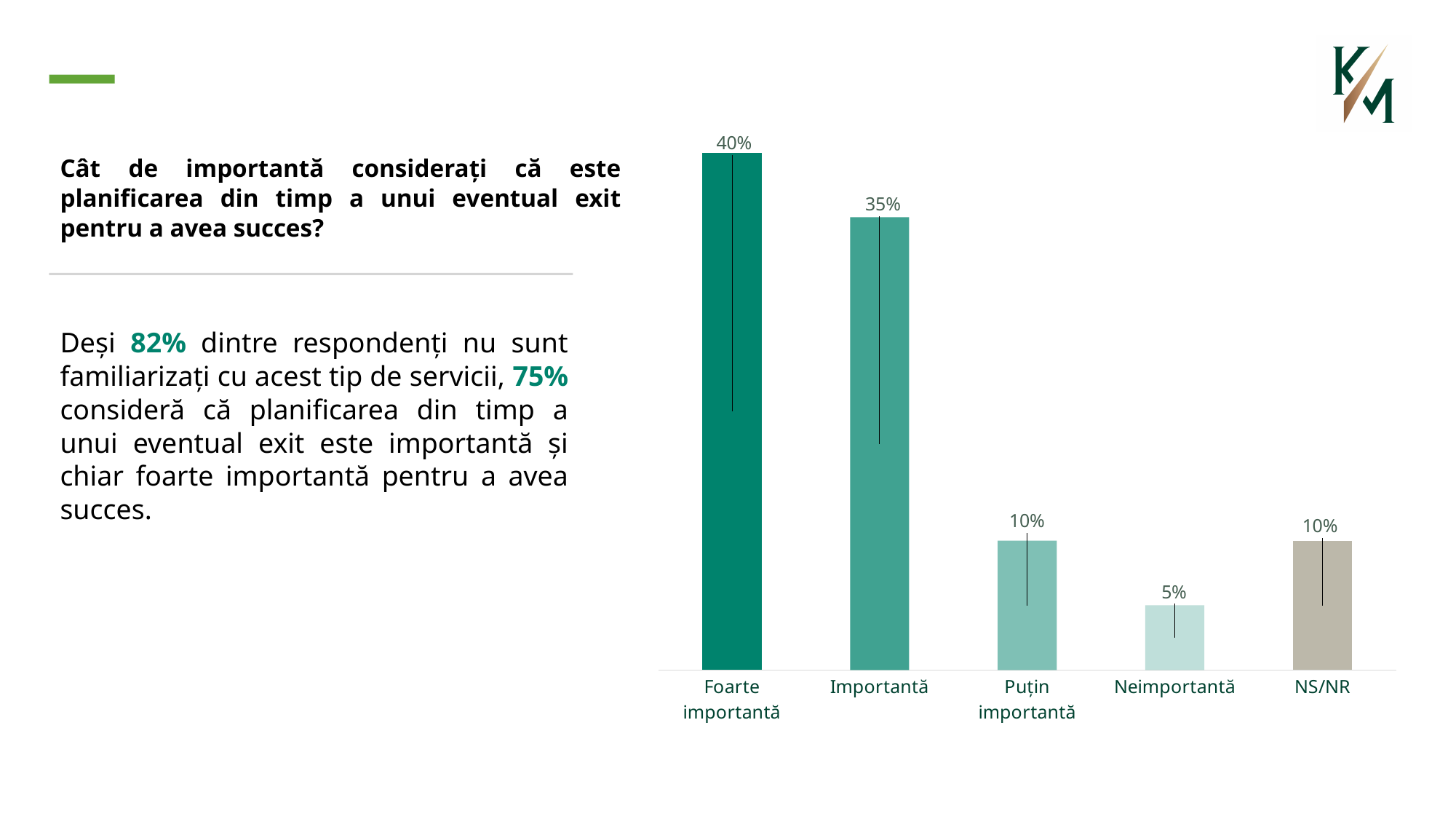
What is the combined value of "Foarte importantă" and "Importantă"? 75% What is the value for "Neimportantă"? 5% What kind of chart is shown on the slide? Bar chart What is the value for "Foarte importantă"? 40% What is the difference between the values for "Foarte importantă" and "Importantă"? 5% Which is larger, the value for "Importantă" or the value for "Puțin importantă"? Importantă Which category has the lowest value? Neimportantă What is the value for "Importantă"? 35% Which category has the highest value? Foarte importantă What is the value for "NS/NR"? 10% What is the difference between the values for "Puțin importantă" and "Neimportantă"? 5% How many categories are shown on the chart? 5